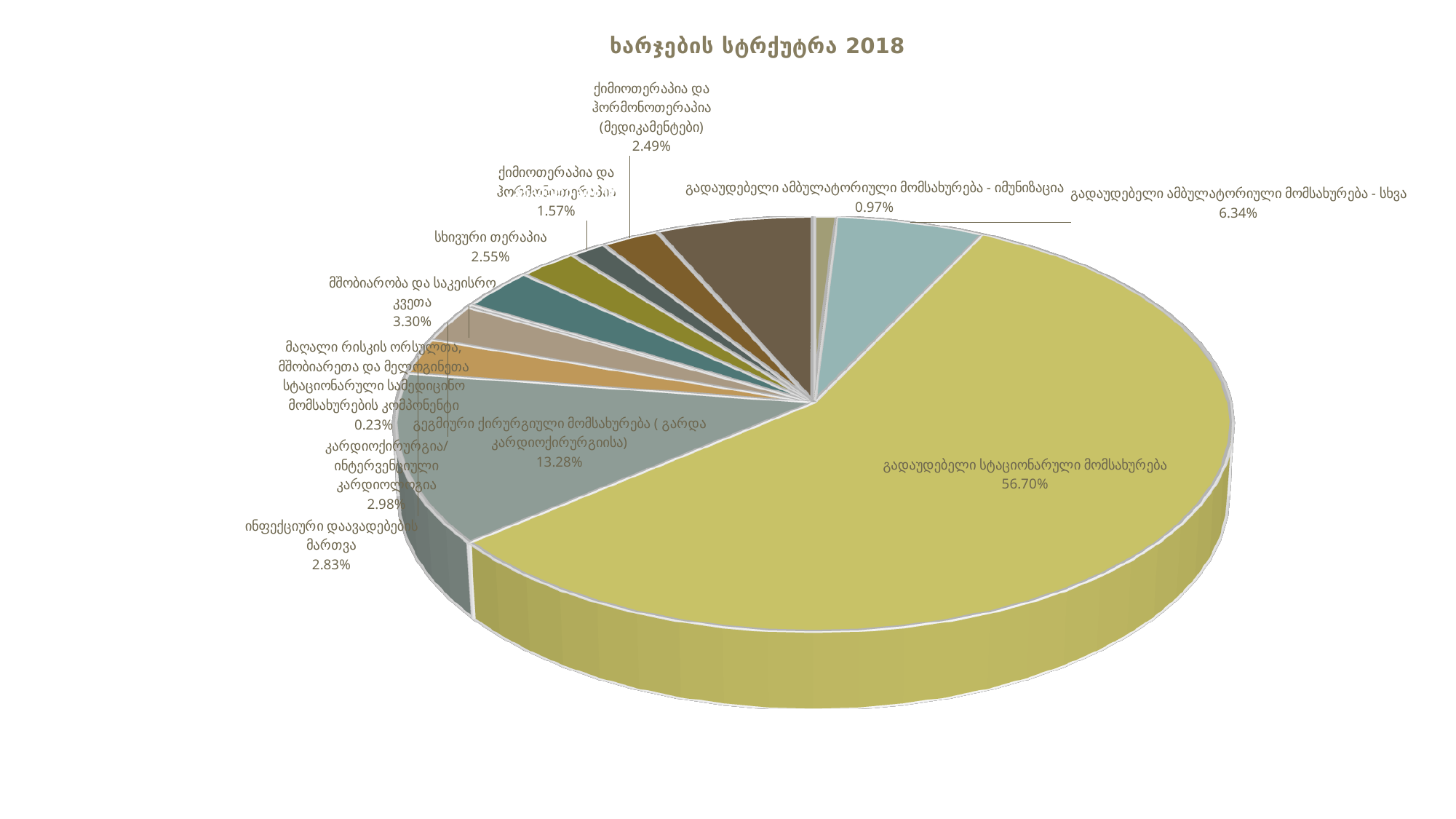
What percentage is shown for გეგმიური ქირურგიული მომსახურება (გარდა კარდიოქირურგიისა)? 13.28% What is the difference in percentage points between გადაუდებელი სტაციონარული მომსახურება and გეგმიური ქირურგიული მომსახურება (გარდა კარდიოქირურგიისა)? 43.42 What percentage is shown for სხივური თერაპია? 2.55% What is the title of the chart? ხარჯების სტრქუტრა 2018 Which category has the largest share of the pie? გადაუდებელი სტაციონარული მომსახურება What kind of chart is shown on the slide? pie chart Which category has the smallest share of the pie? მაღალი რისკის ორსულთა, მშობიარეთა და მელოგინეთა სტაციონარული სამედიცინო მომსახურების კომპონენტი Which has a larger share: ქიმიოთერაპია და ჰორმონოთერაპია (მედიკამენტები) or ქიმიოთერაპია და ჰორმონოთერაპია? ქიმიოთერაპია და ჰორმონოთერაპია (მედიკამენტები) What percentage is shown for გადაუდებელი ამბულატორიული მომსახურება - სხვა? 6.34% What percentage is shown for ინფექციური დაავადებების მართვა? 2.83% What share of the pie is გადაუდებელი სტაციონარული მომსახურება? 56.70% Which has a larger share: მშობიარობა და საკეისრო კვეთა or კარდიოქირურგია/ინტერვენციული კარდიოლოგია? მშობიარობა და საკეისრო კვეთა